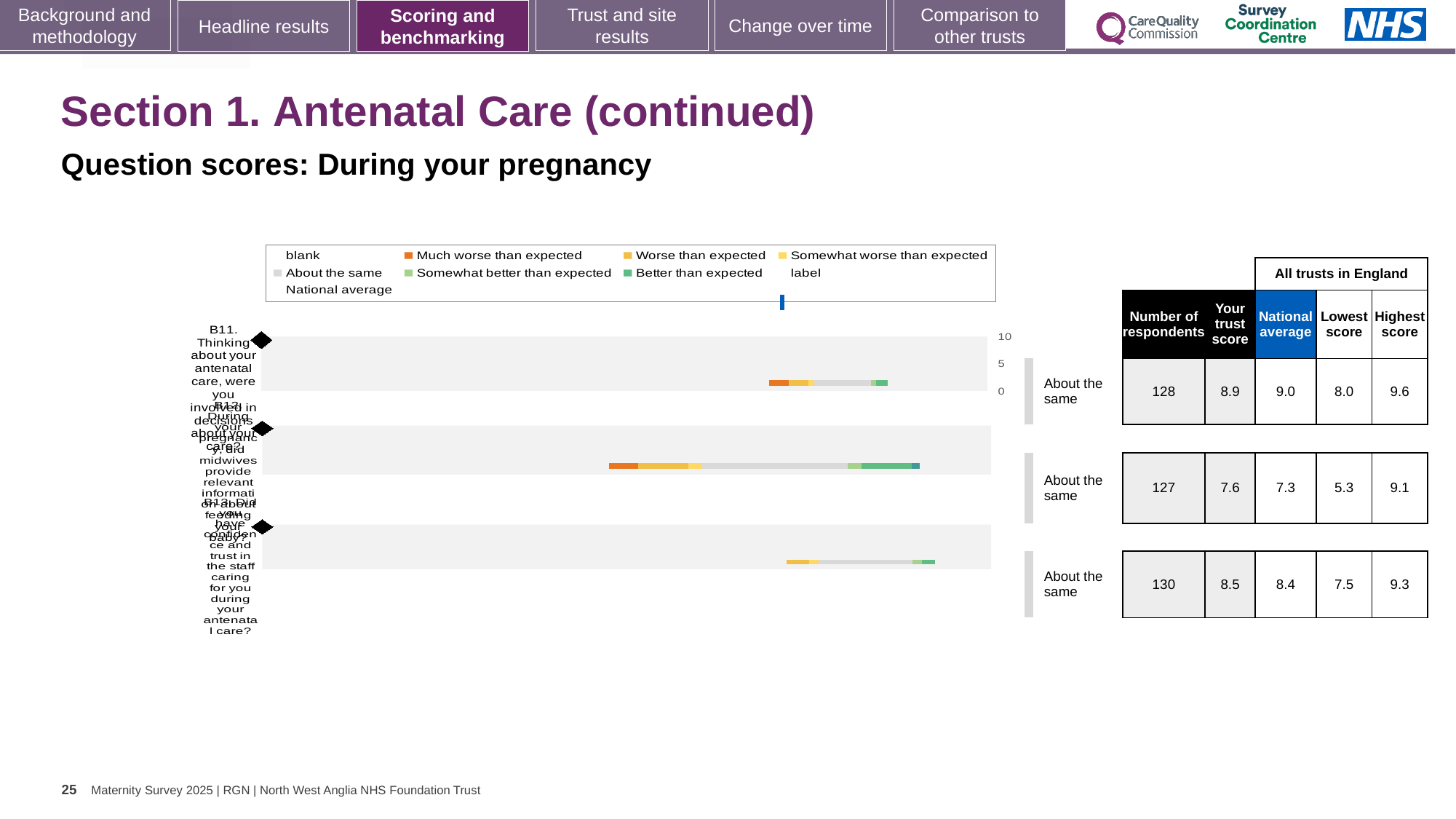
How many respondents answered question B13 (confidence and trust in the staff caring for you)? 130 What benchmark category is shown for all three questions? About the same What kind of chart is shown on the slide? bar chart What is the national average for question B12 (midwives provide relevant information about feeding your baby)? 7.3 Which question has the lowest trust score? B12 What is the difference between the highest score and the lowest score for question B13? 1.8 How many questions (categories) are plotted in the chart? 3 What is the trust score for question B11 (involved in decisions about your care)? 8.9 Which question has the highest trust score? B11 What is the lowest score among all trusts in England for question B12? 5.3 What is the subtitle describing the question scores on this slide? Question scores: During your pregnancy For question B12, which is larger: the trust score or the national average? the trust score